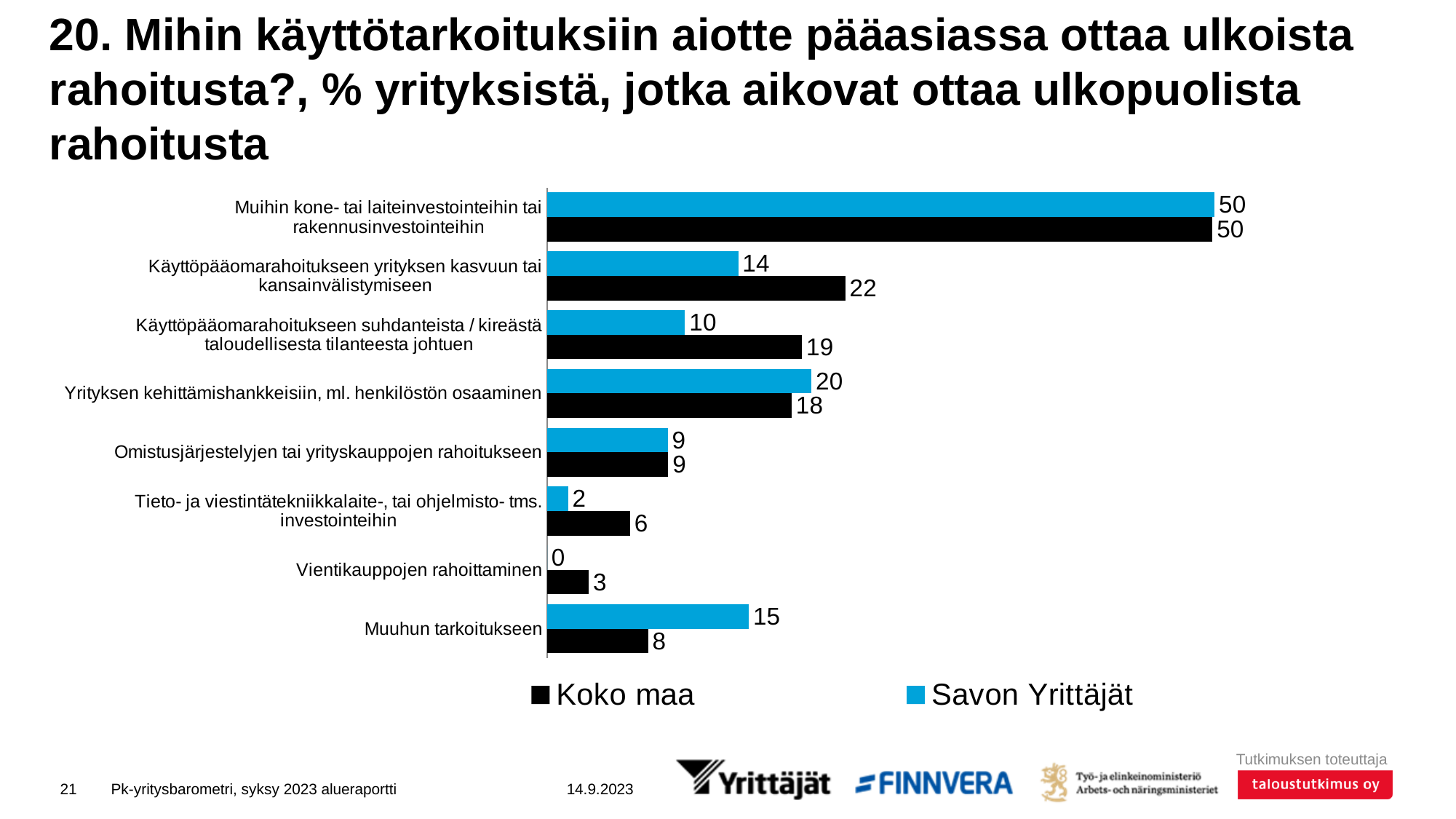
What is the value for Koko maa for 'Tieto- ja viestintätekniikkalaite-, tai ohjelmisto- tms. investointeihin'? 6 What colour are the bars for Savon Yrittäjät? Blue What kind of chart is shown on the slide? Bar chart What is the difference between Koko maa and Savon Yrittäjät for 'Käyttöpääomarahoitukseen yrityksen kasvuun tai kansainvälistymiseen'? 8 Which category has the highest value for Koko maa? Muihin kone- tai laiteinvestointeihin tai rakennusinvestointeihin What is the value for Koko maa for 'Käyttöpääomarahoitukseen suhdanteista / kireästä taloudellisesta tilanteesta johtuen'? 19 Which category has the lowest value for Savon Yrittäjät? Vientikauppojen rahoittaminen What is the value for Savon Yrittäjät for 'Käyttöpääomarahoitukseen yrityksen kasvuun tai kansainvälistymiseen'? 14 For 'Yrityksen kehittämishankkeisiin, ml. henkilöstön osaaminen', which series has the larger value, Koko maa or Savon Yrittäjät? Savon Yrittäjät How many categories are shown in the chart? 8 What is the value for Savon Yrittäjät for 'Muuhun tarkoitukseen'? 15 How many series does the legend list? 2